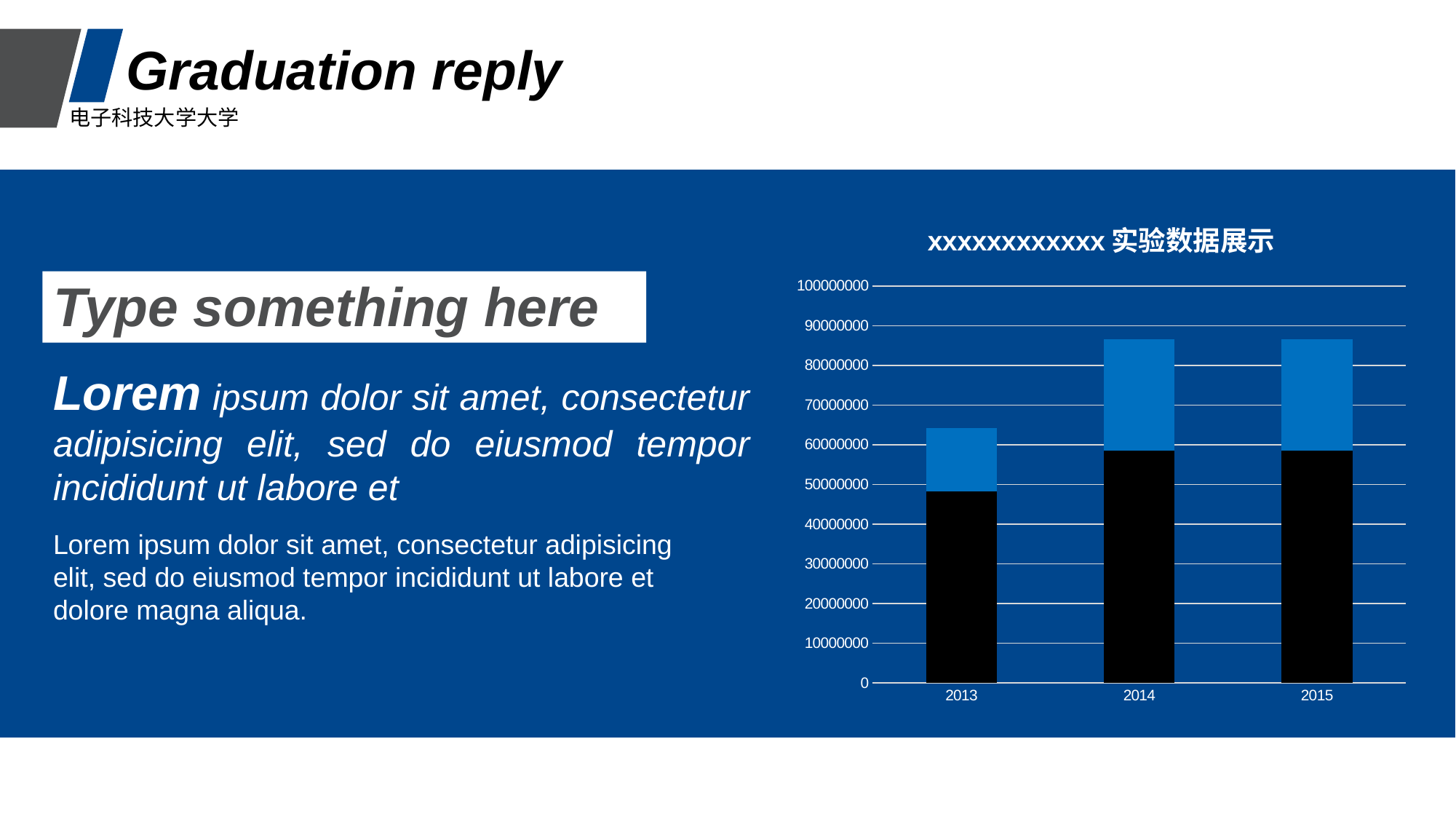
Is the total bar for 2014 greater or less than 80000000? greater Does the total bar rise or fall from 2013 to 2014? rise How many categories are shown on the x axis of the chart? 3 Which year has the lowest total bar in the chart? 2013 What two colours are used for the bar segments in the chart? black and blue Is the total bar for 2015 greater or less than 90000000? less What kind of chart is shown on the slide? stacked bar chart Which total bar is larger, 2013 or 2014? 2014 Is the total bar for 2013 greater or less than 60000000? greater What is the title of the chart? xxxxxxxxxxxx 实验数据展示